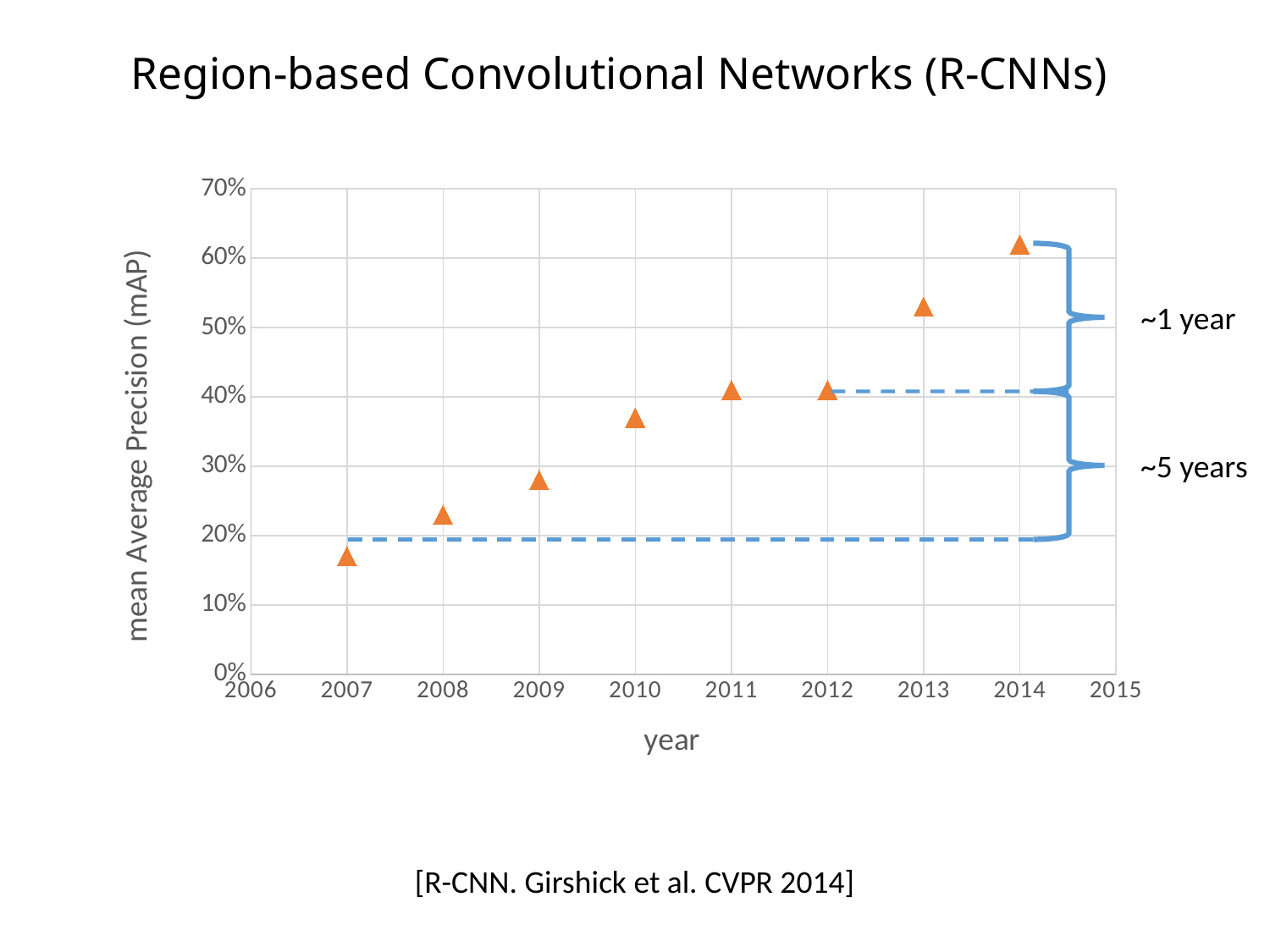
Is the value for 2013 greater or less than 50%? greater Which year has the lowest mean Average Precision? 2007 Is the value for 2010 greater or less than 30%? greater Is the value for 2014 greater or less than 60%? greater What is the label of the vertical axis? mean Average Precision (mAP) What kind of chart is shown on the slide? scatter chart How many data points are plotted on the chart? 8 Which year has the highest mean Average Precision? 2014 Do the mAP values generally rise or fall from 2007 to 2014? rise Which year has a higher mAP, 2010 or 2013? 2013